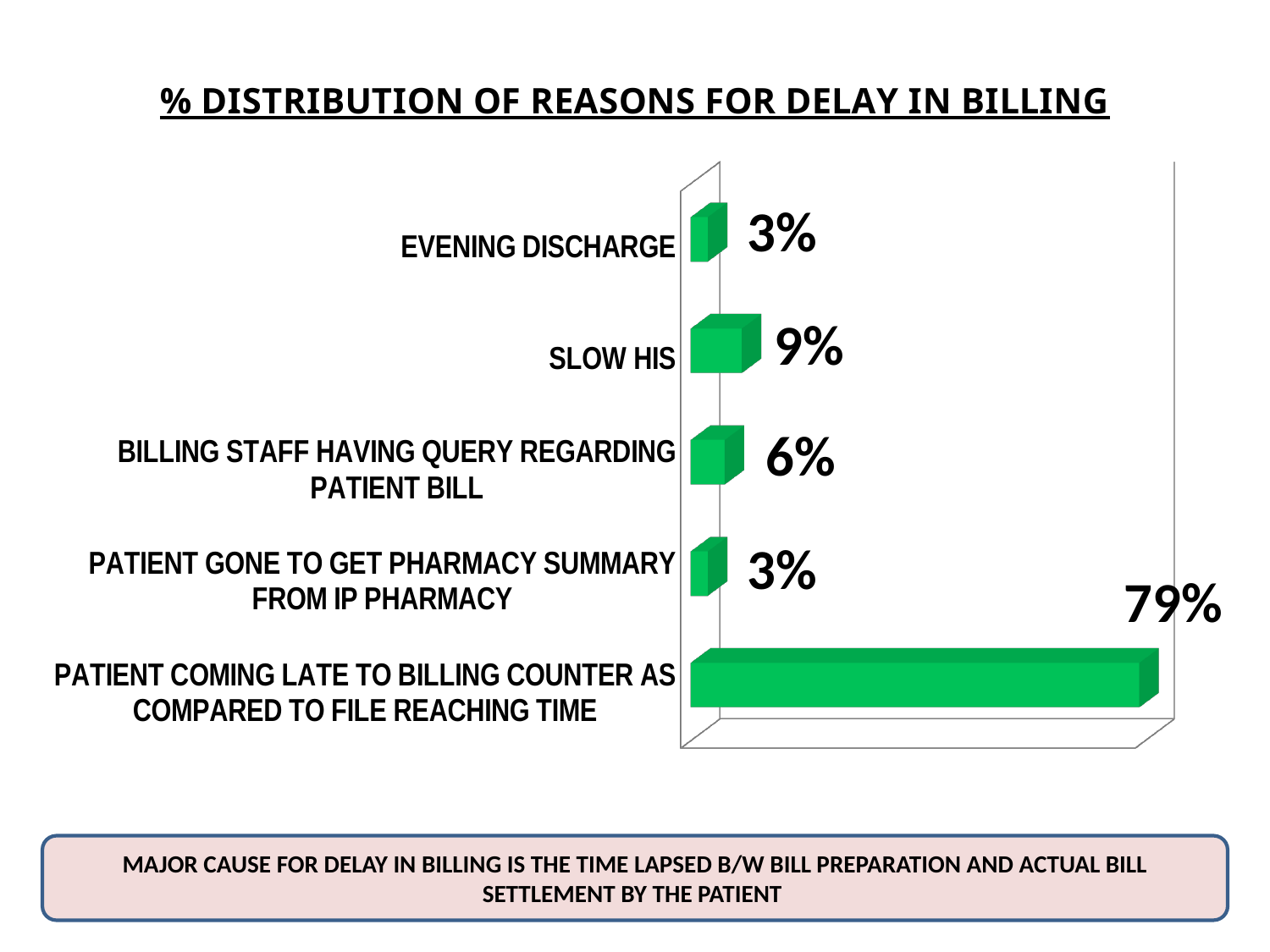
What kind of chart is shown on the slide? Bar chart How many categories are shown in the chart? 5 What is the value for EVENING DISCHARGE? 3% What is the title of the chart? % DISTRIBUTION OF REASONS FOR DELAY IN BILLING Which is larger, the value for SLOW HIS or the value for BILLING STAFF HAVING QUERY REGARDING PATIENT BILL? SLOW HIS Which category has the highest value? PATIENT COMING LATE TO BILLING COUNTER AS COMPARED TO FILE REACHING TIME What is the value for PATIENT COMING LATE TO BILLING COUNTER AS COMPARED TO FILE REACHING TIME? 79% What is the value for BILLING STAFF HAVING QUERY REGARDING PATIENT BILL? 6% What is the value for SLOW HIS? 9% What is the difference between the values for SLOW HIS and BILLING STAFF HAVING QUERY REGARDING PATIENT BILL? 3% What is the difference between the values for PATIENT COMING LATE TO BILLING COUNTER AS COMPARED TO FILE REACHING TIME and SLOW HIS? 70% What colour are the bars in the chart? Green